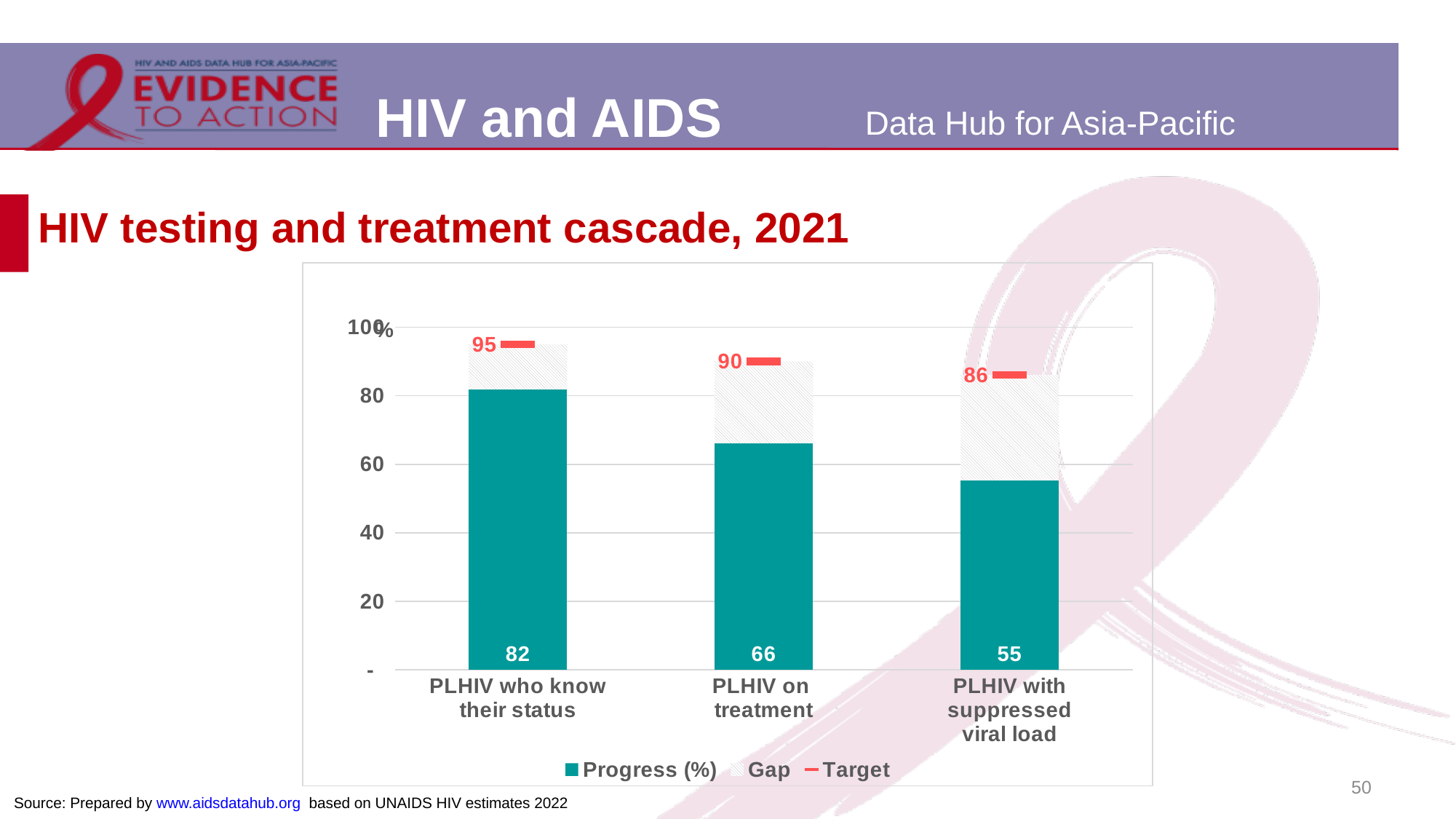
Which category has the lowest Progress (%) value? PLHIV with suppressed viral load What is the Progress (%) value for PLHIV on treatment? 66 Is the Progress (%) value for PLHIV on treatment greater or less than the Target for PLHIV on treatment? less Do the Progress (%) values rise or fall from left to right along the x axis? fall Which category has the highest Progress (%) value? PLHIV who know their status What is the difference between the Target and the Progress (%) value for PLHIV who know their status? 13 What is the Progress (%) value for PLHIV who know their status? 82 What is the Progress (%) value for PLHIV with suppressed viral load? 55 How many categories are shown on the x axis? 3 What is the Target value for PLHIV on treatment? 90 What is the Target value for PLHIV with suppressed viral load? 86 How many series does the legend list? 3